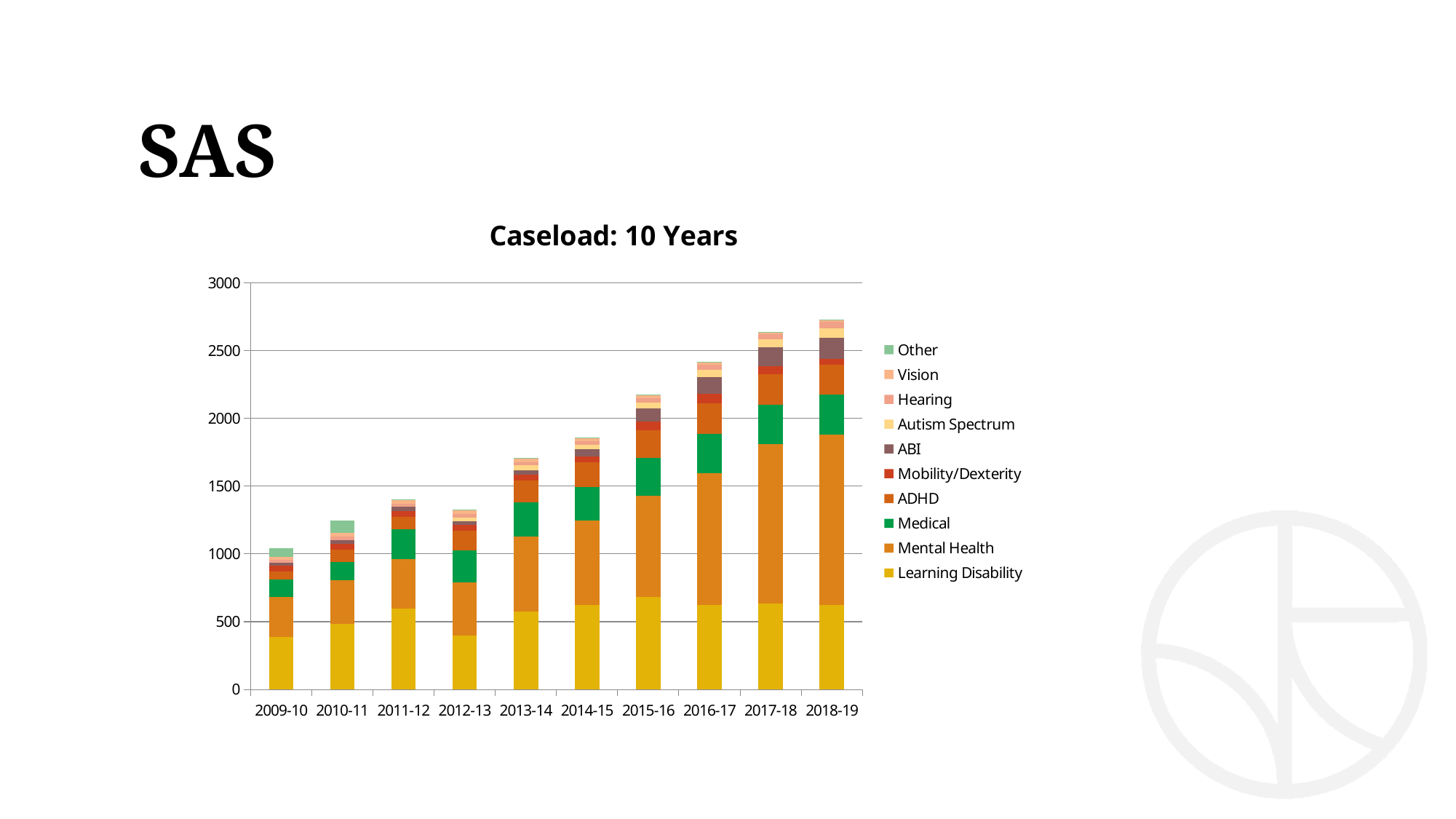
Is the total caseload for 2016-17 greater or less than 2500? less Which year has the highest total caseload? 2018-19 Which series forms the bottom segment of each stacked bar? Learning Disability What kind of chart is shown on the slide? Stacked bar chart How many series does the legend list? 10 Does the total caseload generally rise or fall from 2009-10 to 2018-19? Rise How many years (categories) are shown on the x axis? 10 Is the total caseload for 2012-13 greater or less than 1500? less Which year has the lowest total caseload? 2009-10 What is the title of the chart? Caseload: 10 Years Is the total caseload for 2013-14 greater or less than 1500? greater Which year has the larger total caseload, 2011-12 or 2012-13? 2011-12